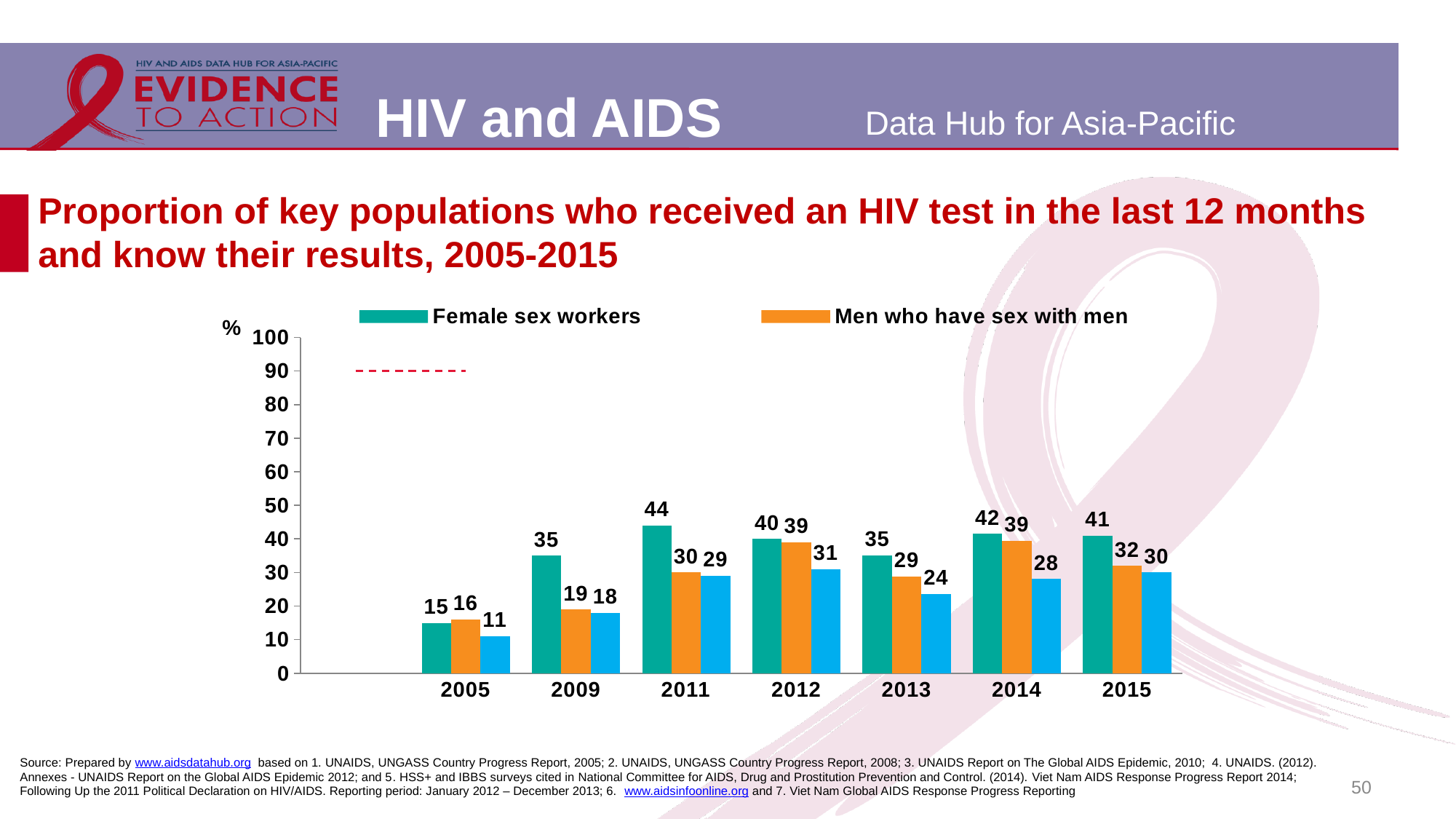
Is the value for Female sex workers in 2015 greater or less than 40? greater What kind of chart is shown on the slide? bar chart What is the difference between the Female sex workers and Men who have sex with men values in 2012? 1 How many years are shown on the x axis? 7 In which year is the value for Men who have sex with men lowest? 2005 Do the values for Female sex workers rise or fall from 2005 to 2011? rise What is the difference between the Female sex workers and Men who have sex with men values in 2009? 16 What is the value for Female sex workers in 2011? 44 What is the value for Men who have sex with men in 2013? 29 In which year is the value for Female sex workers highest? 2011 What is the value for Men who have sex with men in 2014? 39 In 2005, which is larger: the value for Female sex workers or for Men who have sex with men? Men who have sex with men